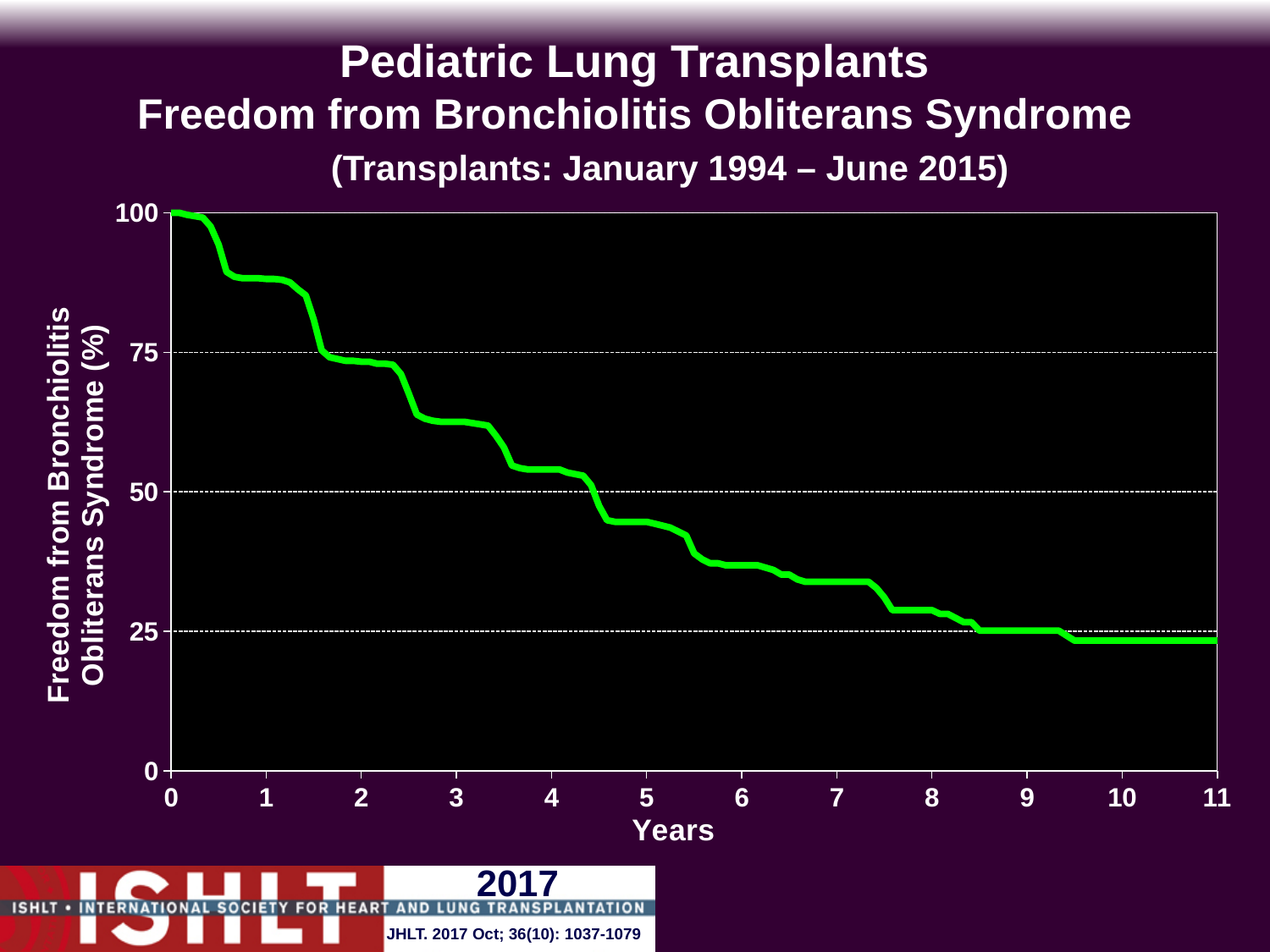
What is the value of freedom from bronchiolitis obliterans syndrome at year 0? 100 What kind of chart is shown on the slide? line chart Which is larger, the value at year 3 or the value at year 6? year 3 Is the value for freedom from bronchiolitis obliterans syndrome at year 5 greater or less than 50? less What is the label of the x axis? Years Is the value for freedom from bronchiolitis obliterans syndrome at year 11 greater or less than 25? less Is the value for freedom from bronchiolitis obliterans syndrome at year 4 greater or less than 50? greater What transplant period does the chart cover, according to the title? January 1994 – June 2015 Does the freedom from bronchiolitis obliterans syndrome rise or fall as years increase? fall